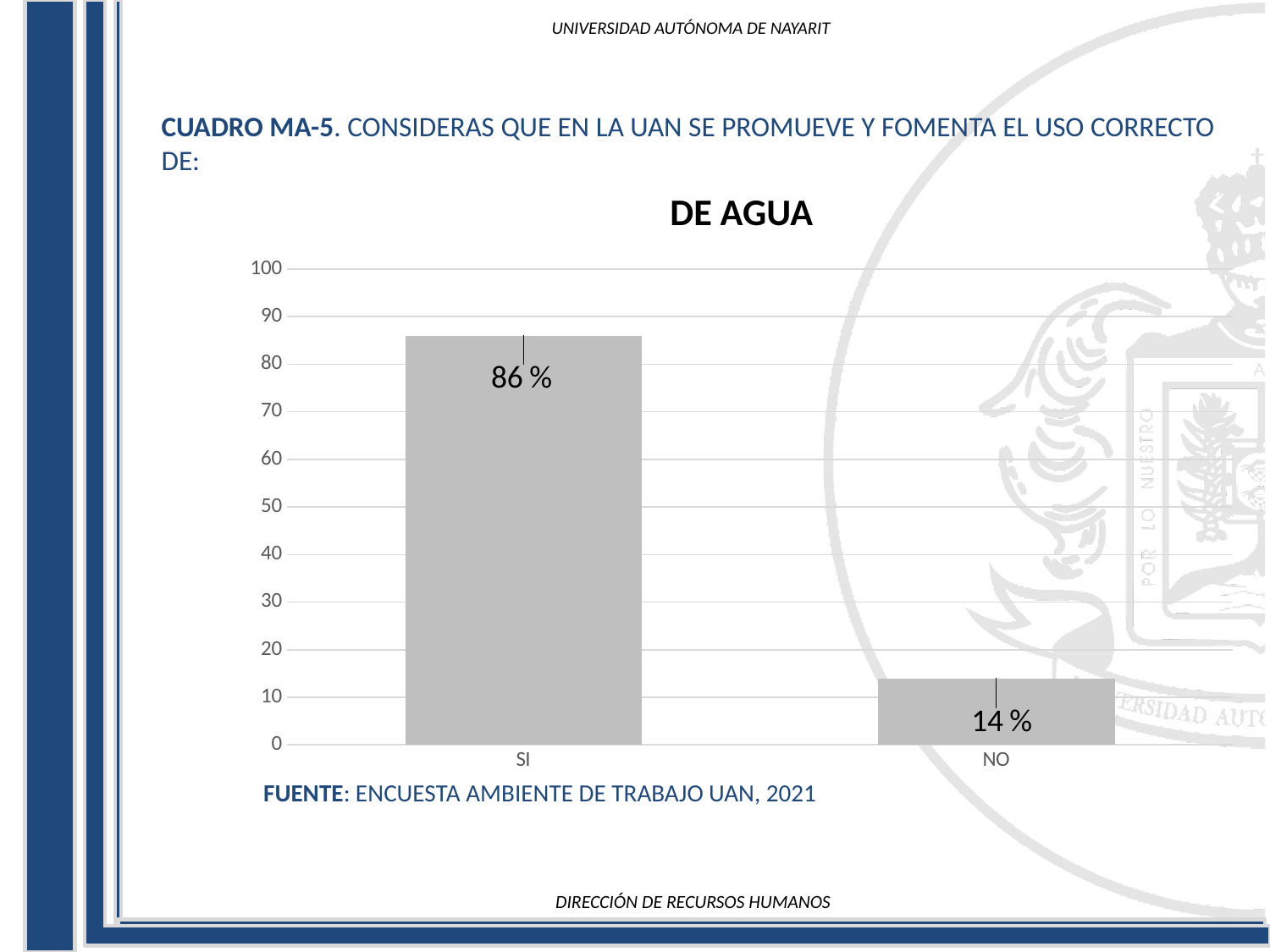
Which is larger, the value for SI or the value for NO? SI Which category has the lowest value? NO How many categories are shown on the x axis? 2 Is the value for NO greater or less than 20? less What is the title of the chart? DE AGUA Is the value for SI greater or less than 80? greater What is the value for SI? 86 % What is the source cited below the chart? ENCUESTA AMBIENTE DE TRABAJO UAN, 2021 What is the difference between the values for SI and NO? 72 % What is the value for NO? 14 % Which category has the highest value? SI What kind of chart is shown on the slide? bar chart